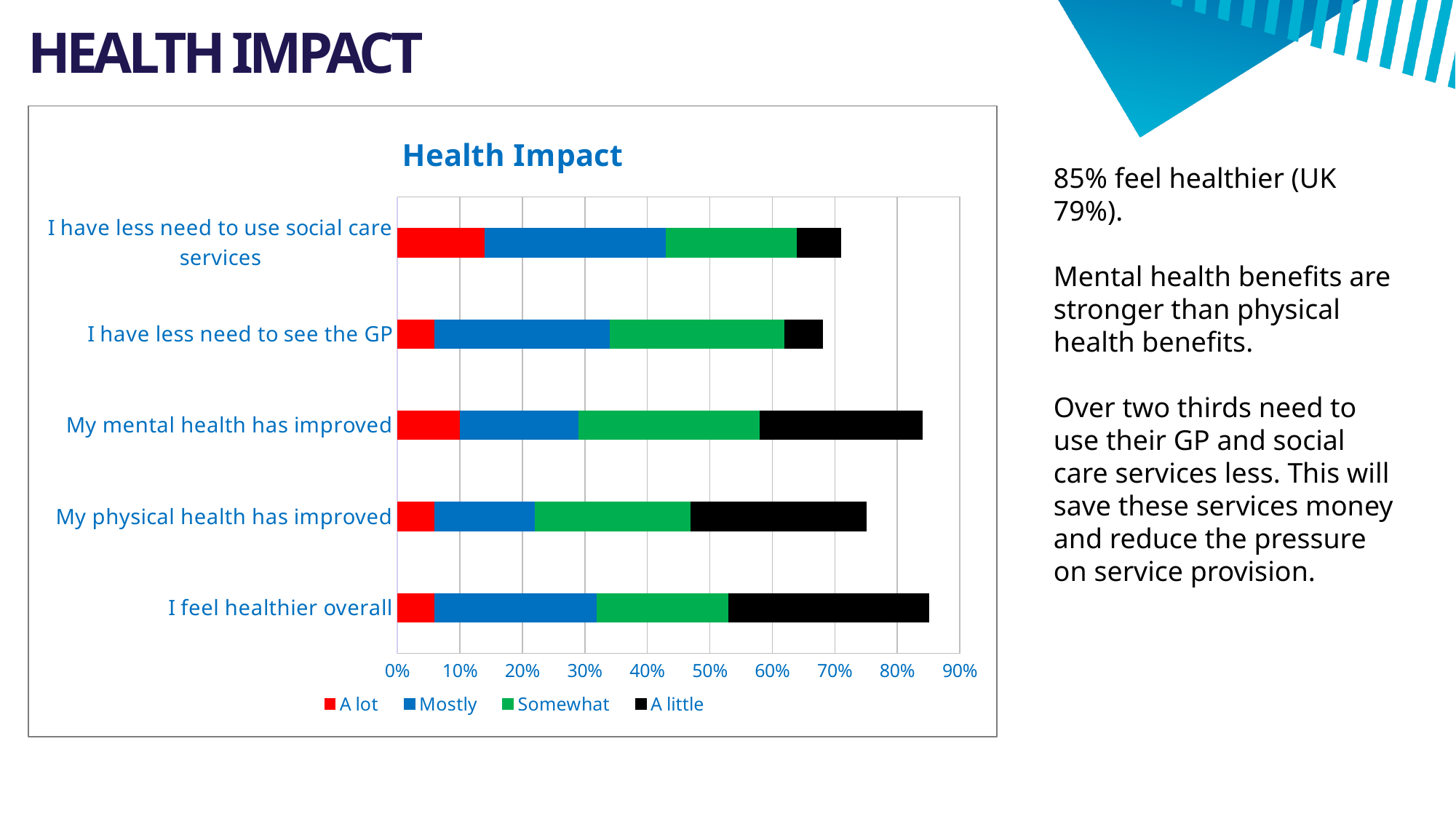
Which colour represents the 'A little' series in the chart? Black Is the total bar length for 'My mental health has improved' greater or less than 80%? greater What is the title of the chart? Health Impact Is the total bar length for 'I have less need to see the GP' greater or less than 70%? less What kind of chart is shown on the slide? Stacked bar chart Which has the larger 'A little' segment: 'My mental health has improved' or 'I have less need to see the GP'? My mental health has improved Is the total bar length for 'My physical health has improved' greater or less than 80%? less How many series does the legend of the Health Impact chart list? 4 Which has the larger 'A lot' segment: 'I have less need to use social care services' or 'I have less need to see the GP'? I have less need to use social care services How many categories (statements) are plotted in the Health Impact chart? 5